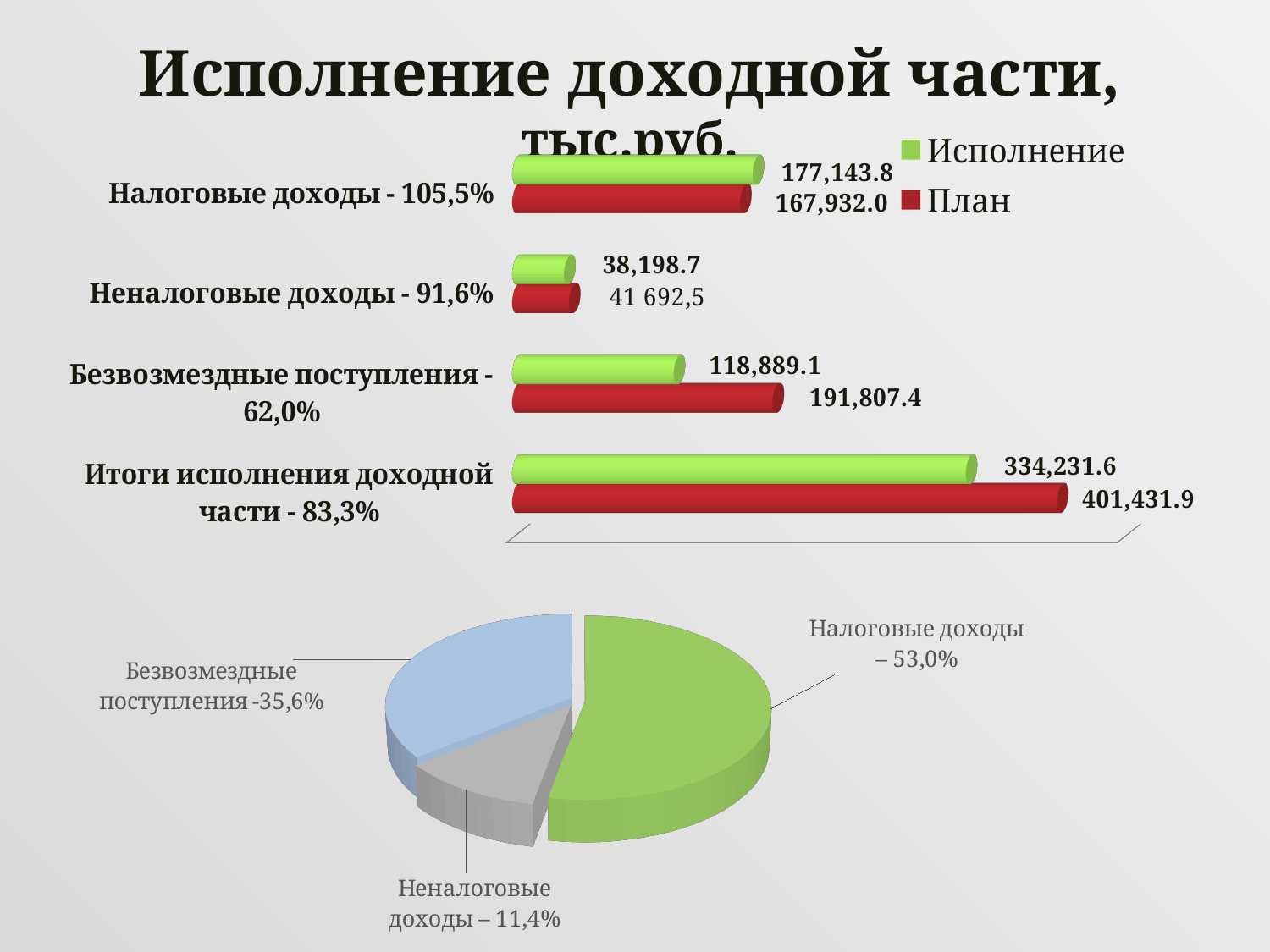
In the bar chart, what is the План value for Безвозмездные поступления? 191,807.4 In the bar chart, which is larger for Налоговые доходы: the Исполнение value or the План value? Исполнение In the bar chart, which category has the lowest План value? Неналоговые доходы What type of chart is the chart at the bottom of the slide? Pie chart In the pie chart, which slice is the smallest? Неналоговые доходы How many series does the legend of the bar chart list? 2 In the bar chart, what is the Исполнение value for Налоговые доходы? 177,143.8 In the bar chart, what is the План value for Итоги исполнения доходной части? 401,431.9 How many categories are shown in the bar chart? 4 In the pie chart, what share does Налоговые доходы have? 53,0% In the bar chart, what is the Исполнение value for Неналоговые доходы? 38,198.7 In the bar chart, what is the difference between the План and Исполнение values for Итоги исполнения доходной части? 67,200.3